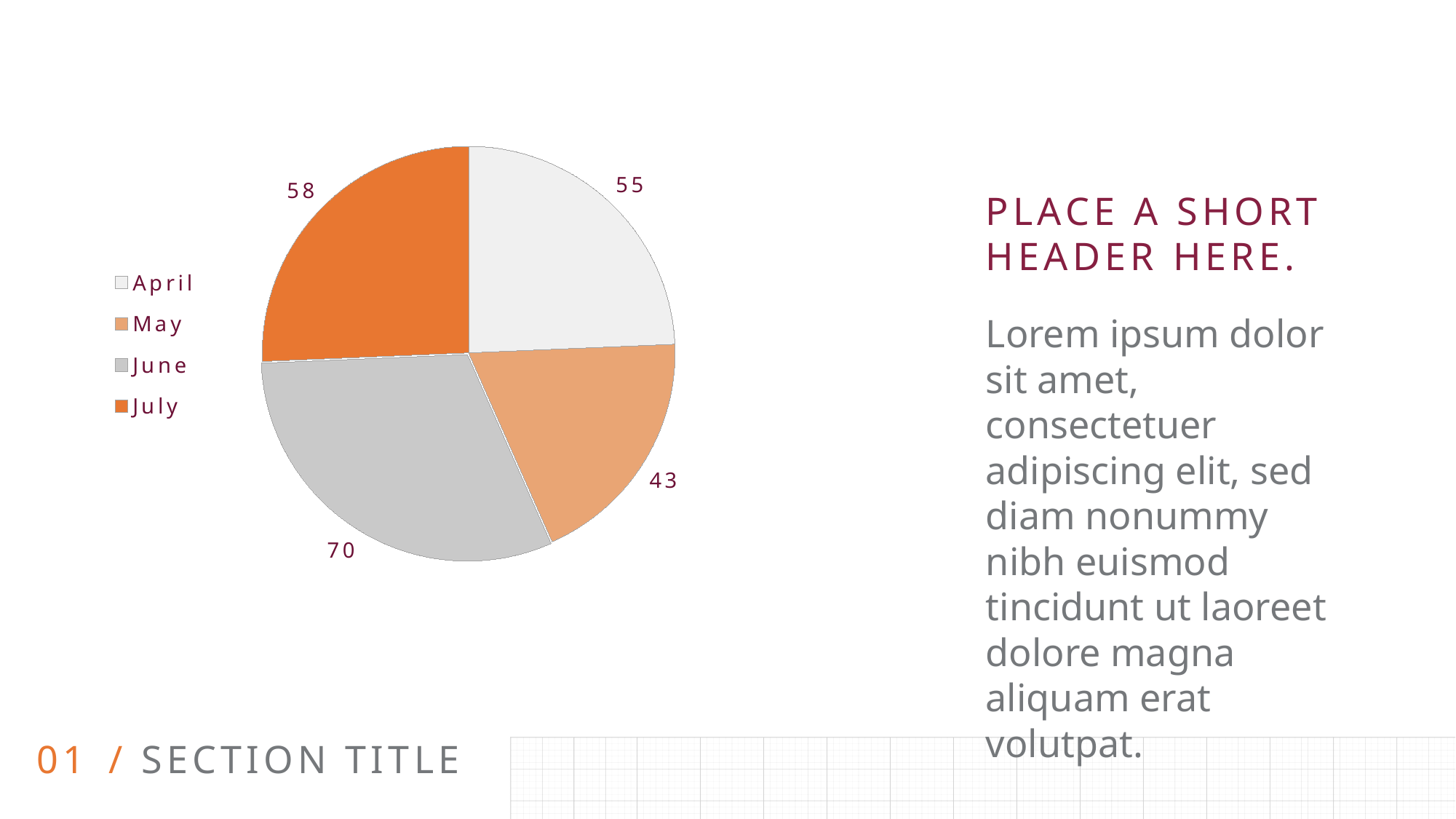
What is the value for July in the pie chart? 58 What is the value for June in the pie chart? 70 What type of chart is shown on the slide? pie chart What is the value for May in the pie chart? 43 What is the total of all the slice values in the pie chart? 226 Which month has the largest slice in the pie chart? June What is the value for April in the pie chart? 55 Which is larger, the value for July or the value for April? July What is the difference between the values for June and May? 27 Which month has the smallest slice in the pie chart? May Which month is shown in the darkest orange colour in the pie chart? July How many slices does the pie chart have? 4